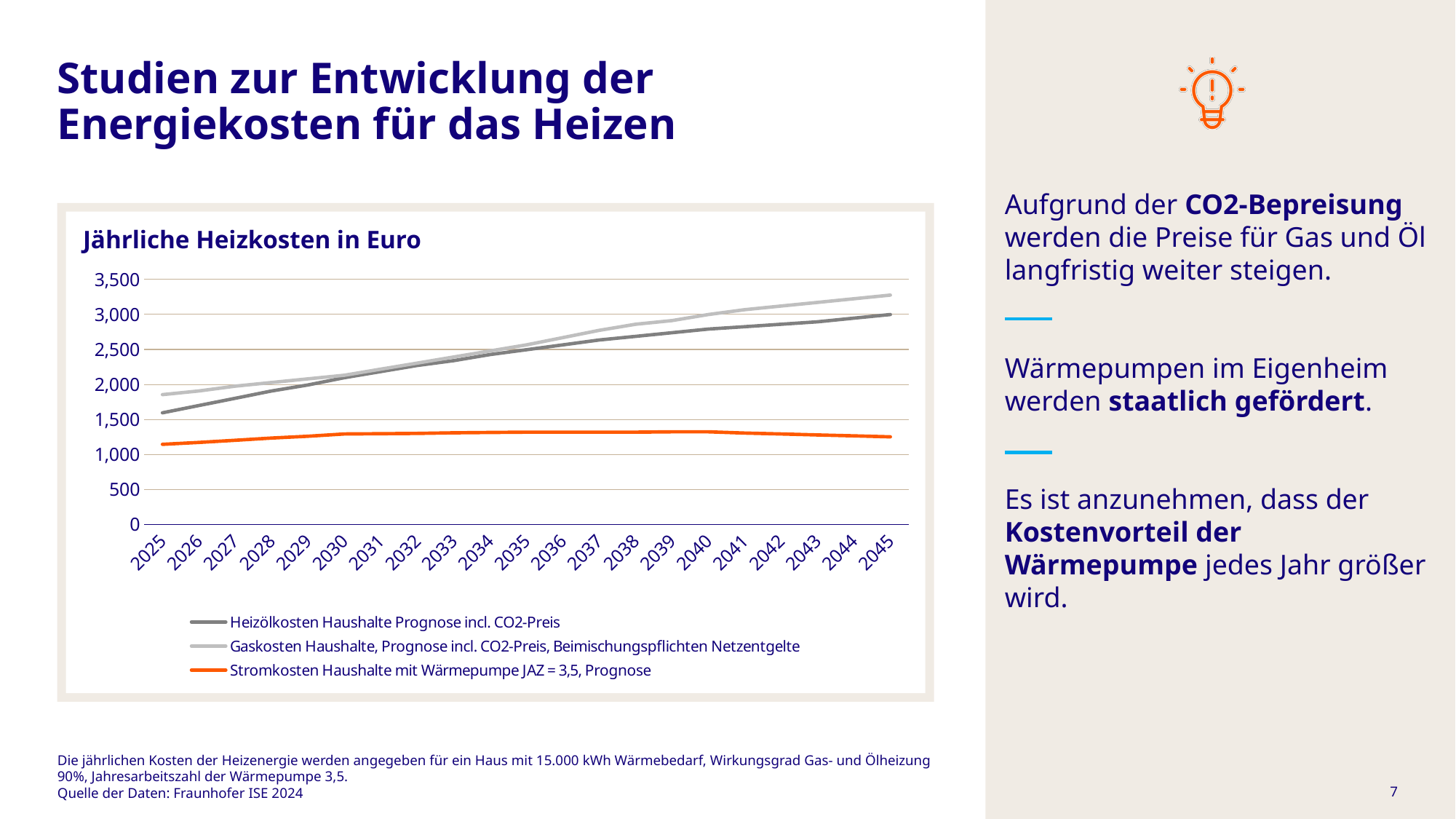
Which series has the lowest value in 2045? Stromkosten Haushalte mit Wärmepumpe JAZ = 3,5, Prognose Which series is drawn in orange in the chart? Stromkosten Haushalte mit Wärmepumpe JAZ = 3,5, Prognose What kind of chart is shown on the slide? line chart Which series has the highest value in 2045? Gaskosten Haushalte, Prognose incl. CO2-Preis, Beimischungspflichten Netzentgelte Is the value for Gaskosten Haushalte in 2045 greater or less than 3,000? greater Is the value for Heizölkosten Haushalte Prognose incl. CO2-Preis in 2025 greater or less than 1,500? greater Do the values for Heizölkosten Haushalte Prognose incl. CO2-Preis rise or fall from 2025 to 2045? rise Is the value for Stromkosten Haushalte mit Wärmepumpe in 2045 greater or less than 1,500? less What is the title of the chart? Jährliche Heizkosten in Euro In 2025, which is higher: Gaskosten Haushalte or Heizölkosten Haushalte? Gaskosten Haushalte How many series does the legend of the chart list? 3 How many years are shown on the x axis of the chart? 21